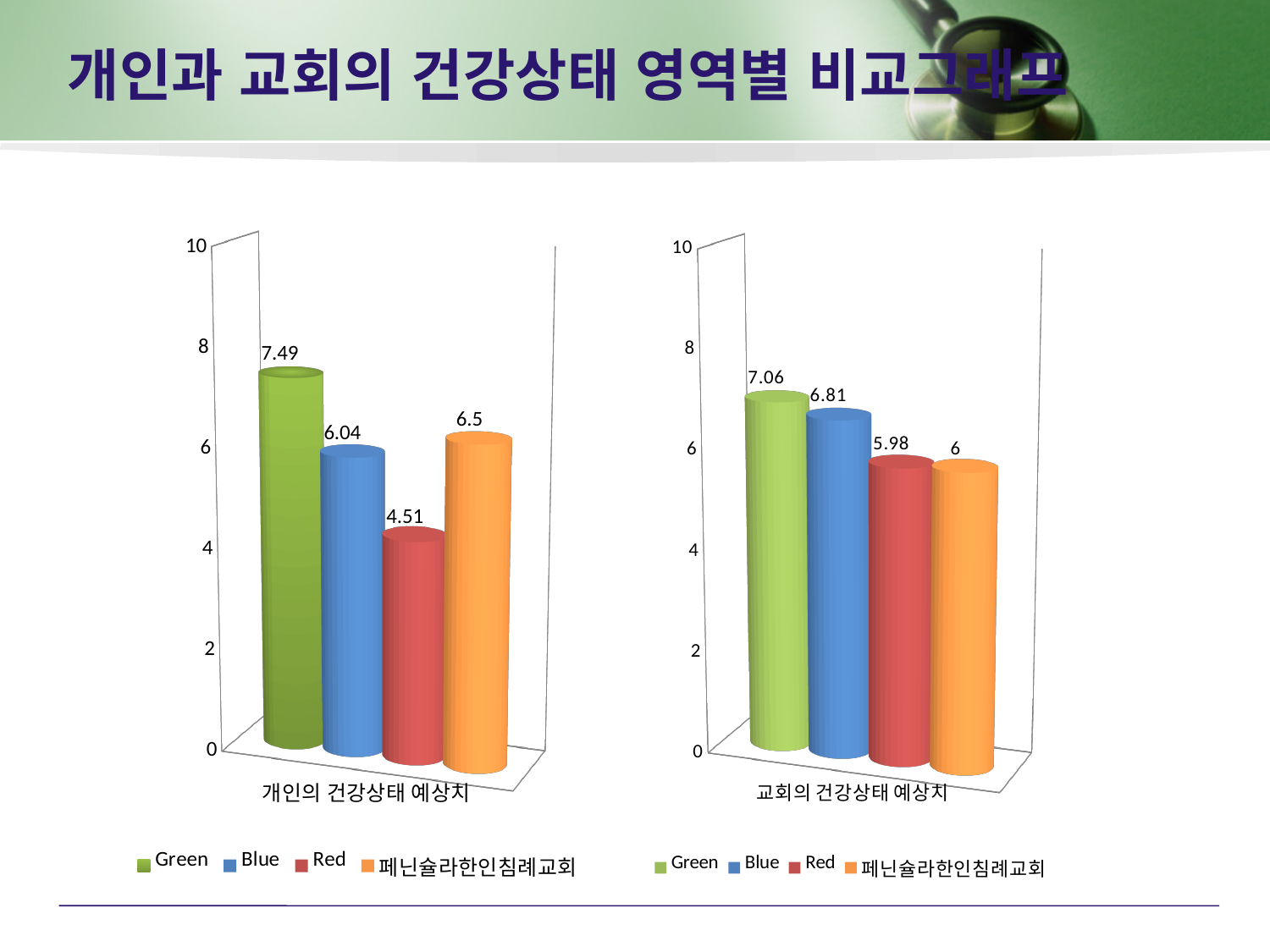
In the left chart (개인의 건강상태 예상치), what is the difference between the Green value and the Red value? 2.98 How many series does the legend of the right chart (교회의 건강상태 예상치) list? 4 In the right chart (교회의 건강상태 예상치), what is the value for 페닌슐라한인침례교회? 6 In the left chart (개인의 건강상태 예상치), which series has the highest value? Green In the left chart (개인의 건강상태 예상치), which is larger, the Blue value or the 페닌슐라한인침례교회 value? 페닌슐라한인침례교회 In the left chart (개인의 건강상태 예상치), what is the value for the Red series? 4.51 In the left chart (개인의 건강상태 예상치), what is the value for the Green series? 7.49 In the left chart (개인의 건강상태 예상치), which series has the lowest value? Red What kind of chart is the left chart (개인의 건강상태 예상치)? Bar chart In the right chart (교회의 건강상태 예상치), which series has the lowest value? 페닌슐라한인침례교회 In the right chart (교회의 건강상태 예상치), what is the value for the Blue series? 6.81 In the right chart (교회의 건강상태 예상치), what is the difference between the Green value and the Blue value? 0.25